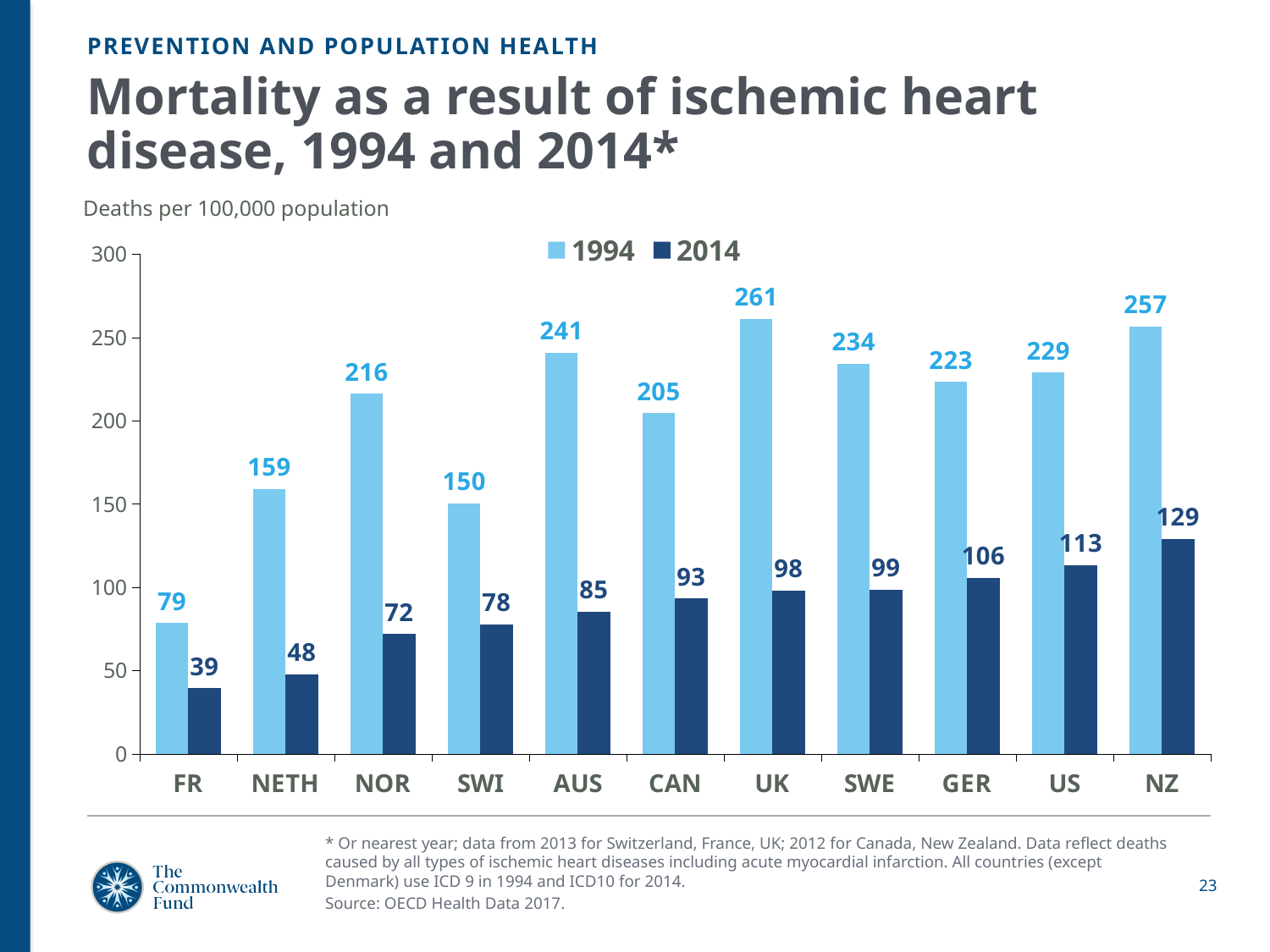
Which is larger, the 2014 value for Germany or the 2014 value for the US? US Which country had the lowest mortality rate in 2014? FR Is the 1994 value for Switzerland greater or less than 200? less What unit is the chart measured in, according to the subtitle? Deaths per 100,000 population What is the difference between the 1994 and 2014 mortality rates for New Zealand? 128 What kind of chart is shown on the slide? bar chart What was the ischemic heart disease mortality rate for the UK in 1994? 261 How many countries are shown on the chart? 11 Which country had the highest mortality rate in 1994? UK What was the ischemic heart disease mortality rate for France in 2014? 39 How many series does the legend list? 2 Which year does the dark blue series represent? 2014